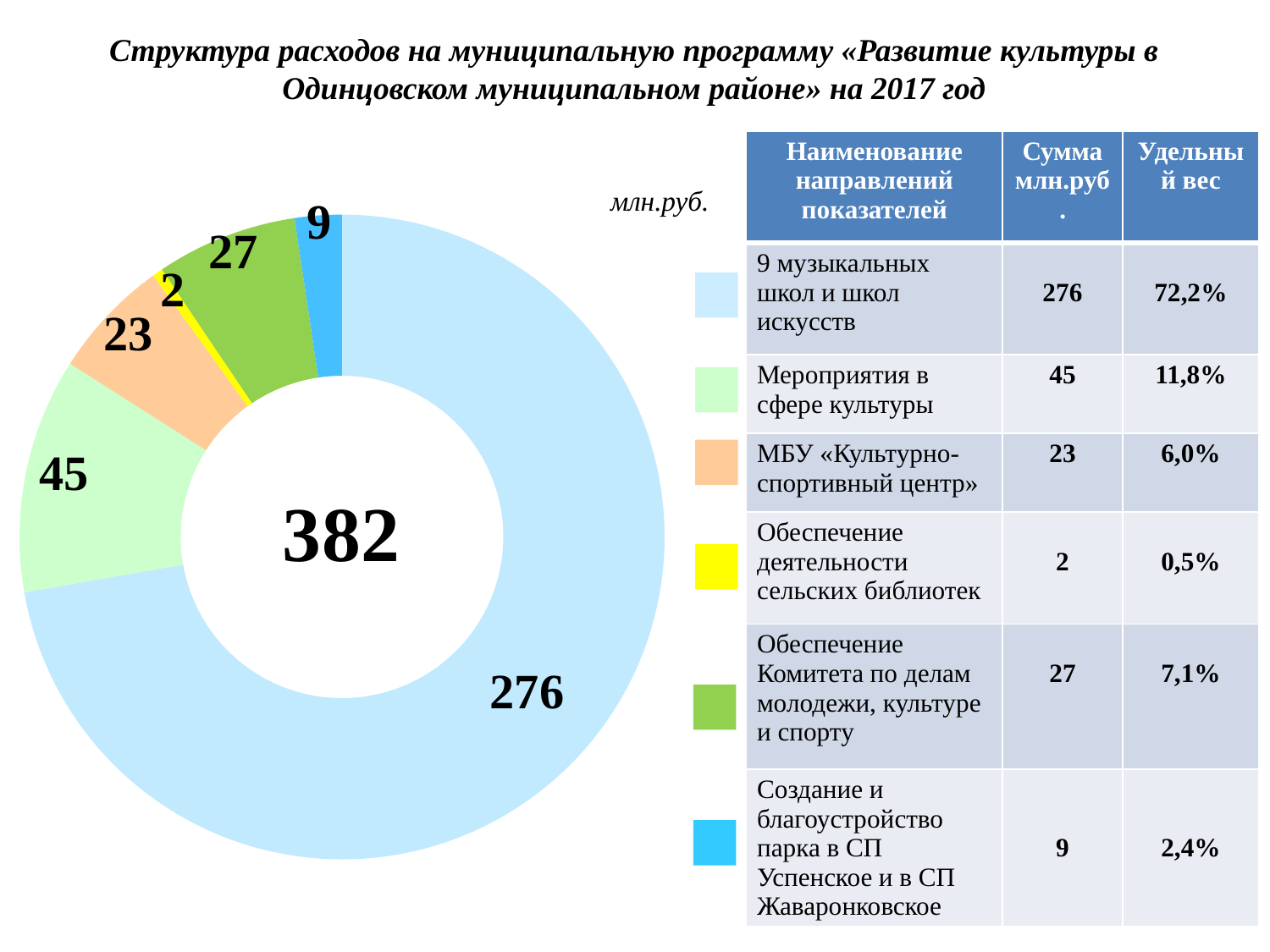
What is the difference between the values for «Мероприятия в сфере культуры» and «МБУ «Культурно-спортивный центр»»? 22 What kind of chart is shown on the slide? doughnut (pie) chart Which category has the largest slice in the chart? 9 музыкальных школ и школ искусств Which category has the smallest slice in the chart? Обеспечение деятельности сельских библиотек What share of the total does «9 музыкальных школ и школ искусств» represent? 72,2% How many slices does the chart have? 6 What is the value for «МБУ «Культурно-спортивный центр»» in the chart? 23 What is the value for «Обеспечение деятельности сельских библиотек» in the chart? 2 What is the value for «Мероприятия в сфере культуры» in the chart? 45 What is the value for «9 музыкальных школ и школ искусств» in the chart? 276 What is the total shown in the centre of the chart? 382 Which is larger: the value for «Обеспечение Комитета по делам молодежи, культуре и спорту» or for «Создание и благоустройство парка в СП Успенское и в СП Жаваронковское»? Обеспечение Комитета по делам молодежи, культуре и спорту